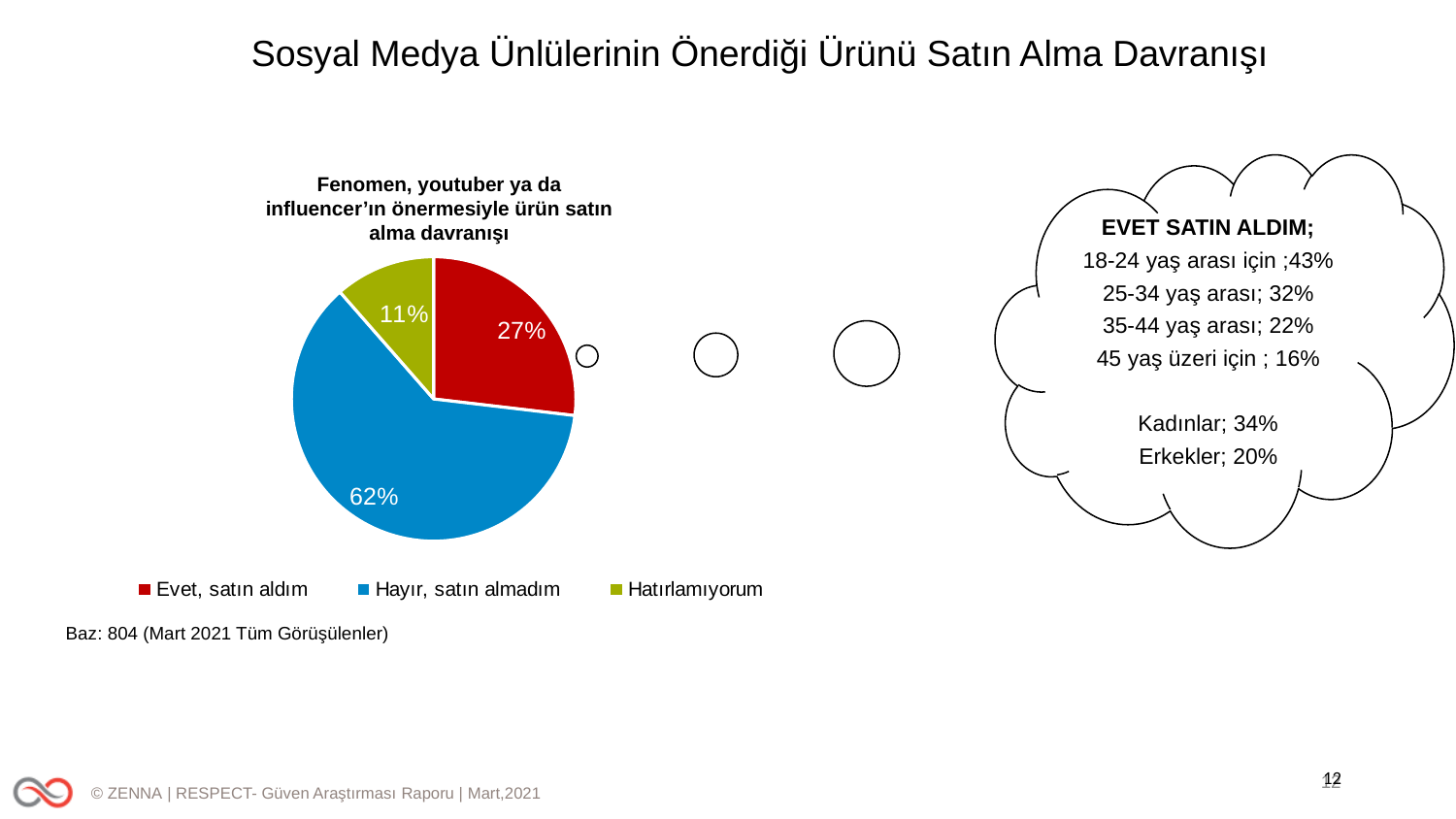
What percentage of respondents answered "Evet, satın aldım"? 27% How many entries does the legend list? 3 Which response has the largest share of the pie? Hayır, satın almadım What percentage of respondents answered "Hatırlamıyorum"? 11% What is the title of the pie chart? Fenomen, youtuber ya da influencer'ın önermesiyle ürün satın alma davranışı Which is larger: the share for "Evet, satın aldım" or the share for "Hatırlamıyorum"? Evet, satın aldım What is the difference in percentage points between "Hayır, satın almadım" and "Evet, satın aldım"? 35 What colour is the slice for "Hayır, satın almadım"? blue What type of chart is shown on the slide? pie chart How many slices does the pie chart have? 3 What percentage of respondents answered "Hayır, satın almadım"? 62% Which response has the smallest share of the pie? Hatırlamıyorum